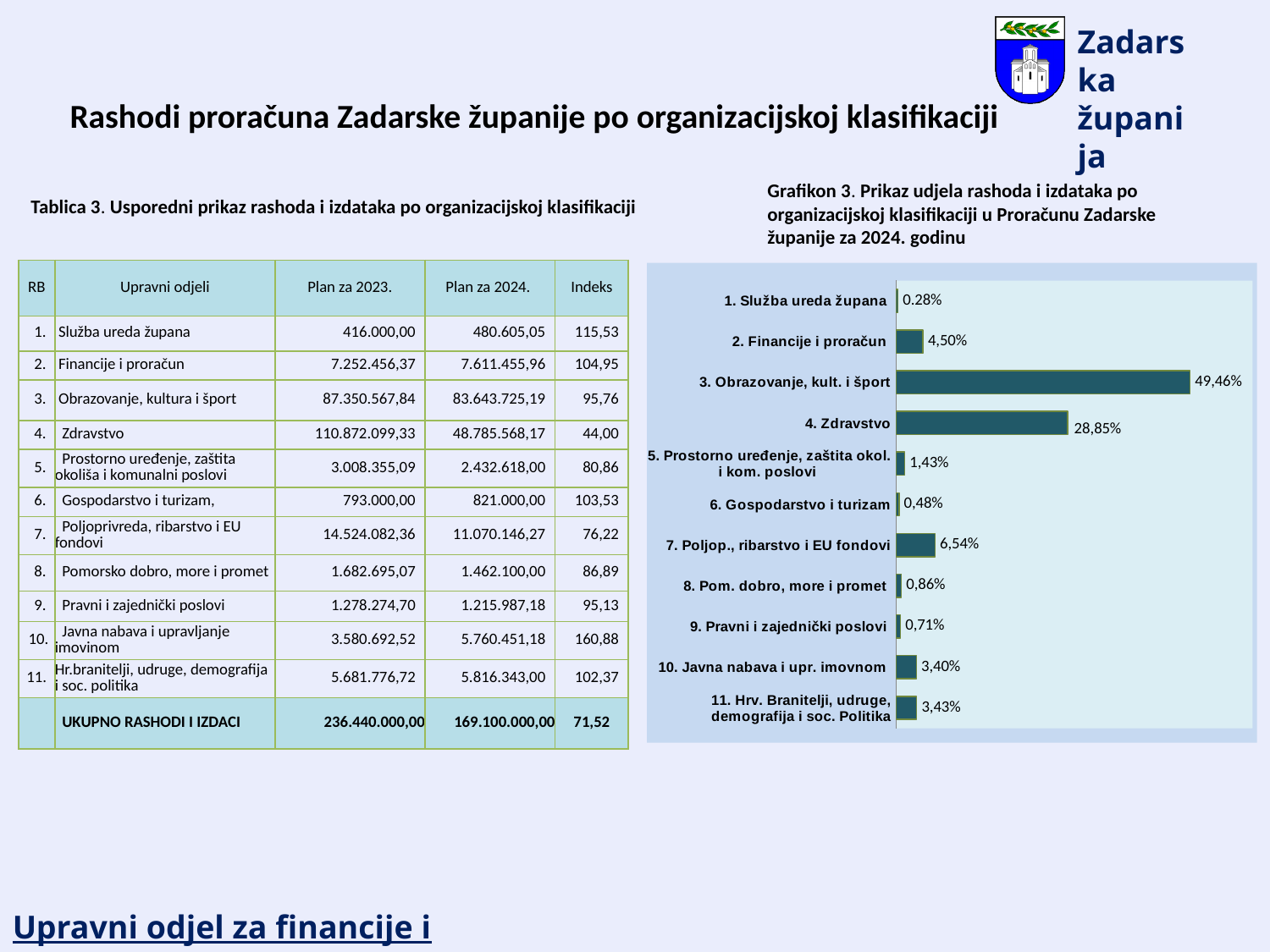
What is the difference between the values for "3. Obrazovanje, kult. i šport" and "4. Zdravstvo"? 20,61% Which has a larger value, "2. Financije i proračun" or "7. Poljop., ribarstvo i EU fondovi"? 7. Poljop., ribarstvo i EU fondovi Which has a larger value, "5. Prostorno uređenje, zaštita okol. i kom. poslovi" or "8. Pom. dobro, more i promet"? 5. Prostorno uređenje, zaštita okol. i kom. poslovi Which category has the lowest value in the chart? 1. Služba ureda župana What is the value for "10. Javna nabava i upr. imovnom" in the chart? 3,40% What is the title of the chart? Grafikon 3. Prikaz udjela rashoda i izdataka po organizacijskoj klasifikaciji u Proračunu Zadarske županije za 2024. godinu Which category has the highest value in the chart? 3. Obrazovanje, kult. i šport How many categories are shown in the chart? 11 What is the value for "3. Obrazovanje, kult. i šport" in the chart? 49,46% What is the value for "7. Poljop., ribarstvo i EU fondovi" in the chart? 6,54% What kind of chart is shown on the slide? bar chart What is the value for "4. Zdravstvo" in the chart? 28,85%